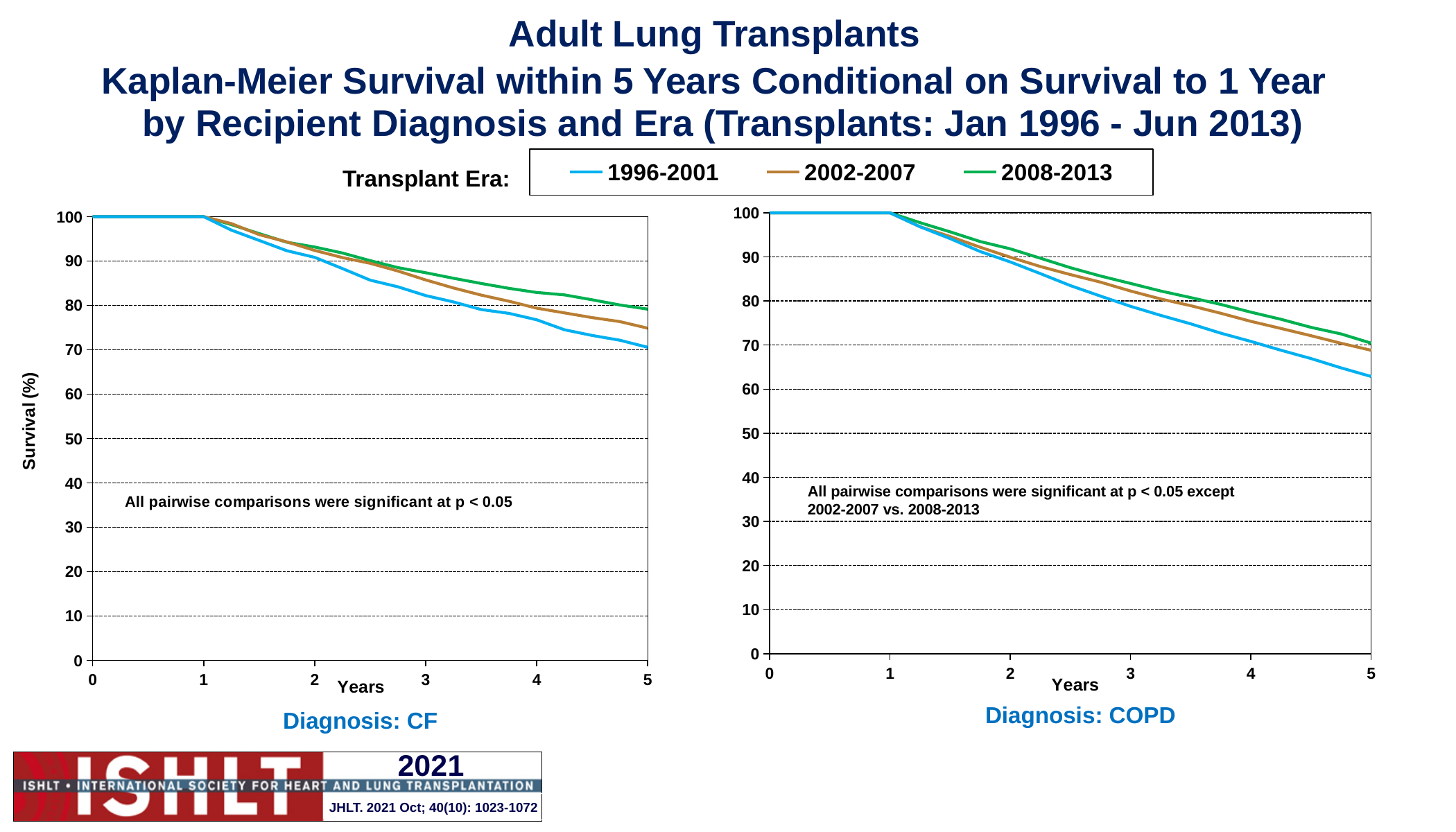
In the Diagnosis: COPD chart, is the survival for the 2008-2013 era at year 3 greater or less than 80? greater In the Diagnosis: COPD chart, what is the survival value for the 2008-2013 era at year 1? 100 In the Diagnosis: CF chart, do the survival values rise or fall as years increase from 1 to 5? fall In the Diagnosis: CF chart, what kind of chart is shown? line chart In the Diagnosis: CF chart, which era has the highest survival at year 5? 2008-2013 In the Diagnosis: CF chart, which era has the lowest survival at year 5? 1996-2001 In the Diagnosis: COPD chart, which era has the lowest survival at year 5? 1996-2001 In the Diagnosis: COPD chart, at year 4, is survival higher for the 2002-2007 era or the 1996-2001 era? 2002-2007 What colour is the line for the 1996-2001 era in the legend? blue In the Diagnosis: CF chart, is the survival for the 2008-2013 era at year 5 greater or less than 70? greater In the Diagnosis: COPD chart, is the survival for the 1996-2001 era at year 5 greater or less than 70? less How many transplant eras does the legend list? 3